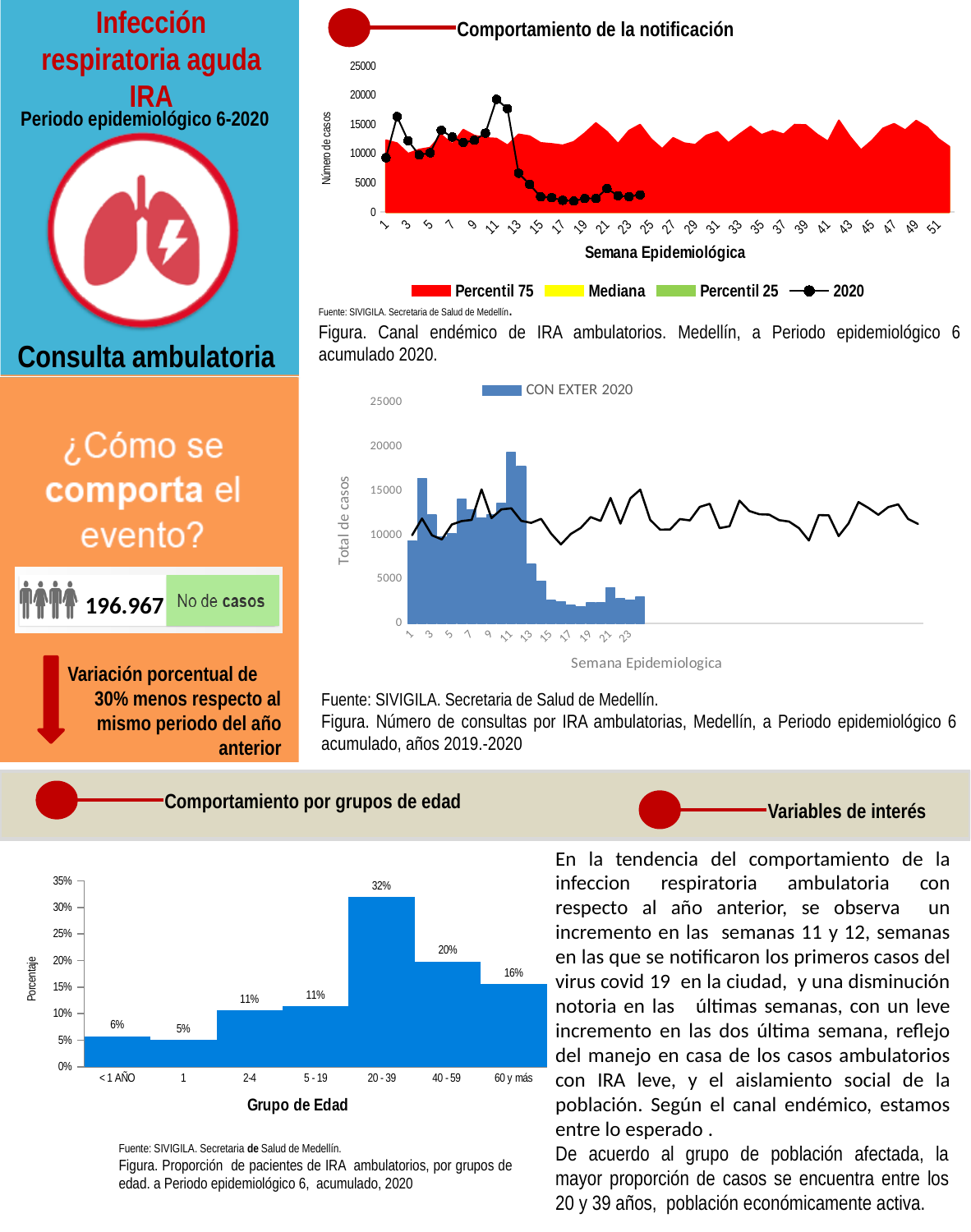
In the chart titled 'Grupo de Edad' (bottom left), what is the percentage for the 60 y más age group? 16% In the 'CON EXTER 2020' chart in the middle right, is the value of the bar for week 17 greater or less than 5000? less In the 'Comportamiento de la notificación' chart at the top right, what is the label of the x axis? Semana Epidemiológica In the 'CON EXTER 2020' chart in the middle right, is the value of the bar for week 11 greater or less than 15000? greater In the chart titled 'Grupo de Edad' (bottom left), which is larger: the percentage for < 1 AÑO or for 1? < 1 AÑO In the chart titled 'Grupo de Edad' (bottom left), what is the percentage for the 20 - 39 age group? 32% In the chart titled 'Grupo de Edad' (bottom left), what is the difference between the percentages for the 20 - 39 and 40 - 59 age groups? 12% How many series does the legend list in the 'Comportamiento de la notificación' chart at the top right? 4 How many age groups are shown in the chart titled 'Grupo de Edad' (bottom left)? 7 In the chart titled 'Grupo de Edad' (bottom left), which age group has the lowest percentage? 1 In the chart titled 'Grupo de Edad' (bottom left), which age group has the highest percentage? 20 - 39 What kind of chart is the 'Grupo de Edad' chart at the bottom left of the slide? Bar chart